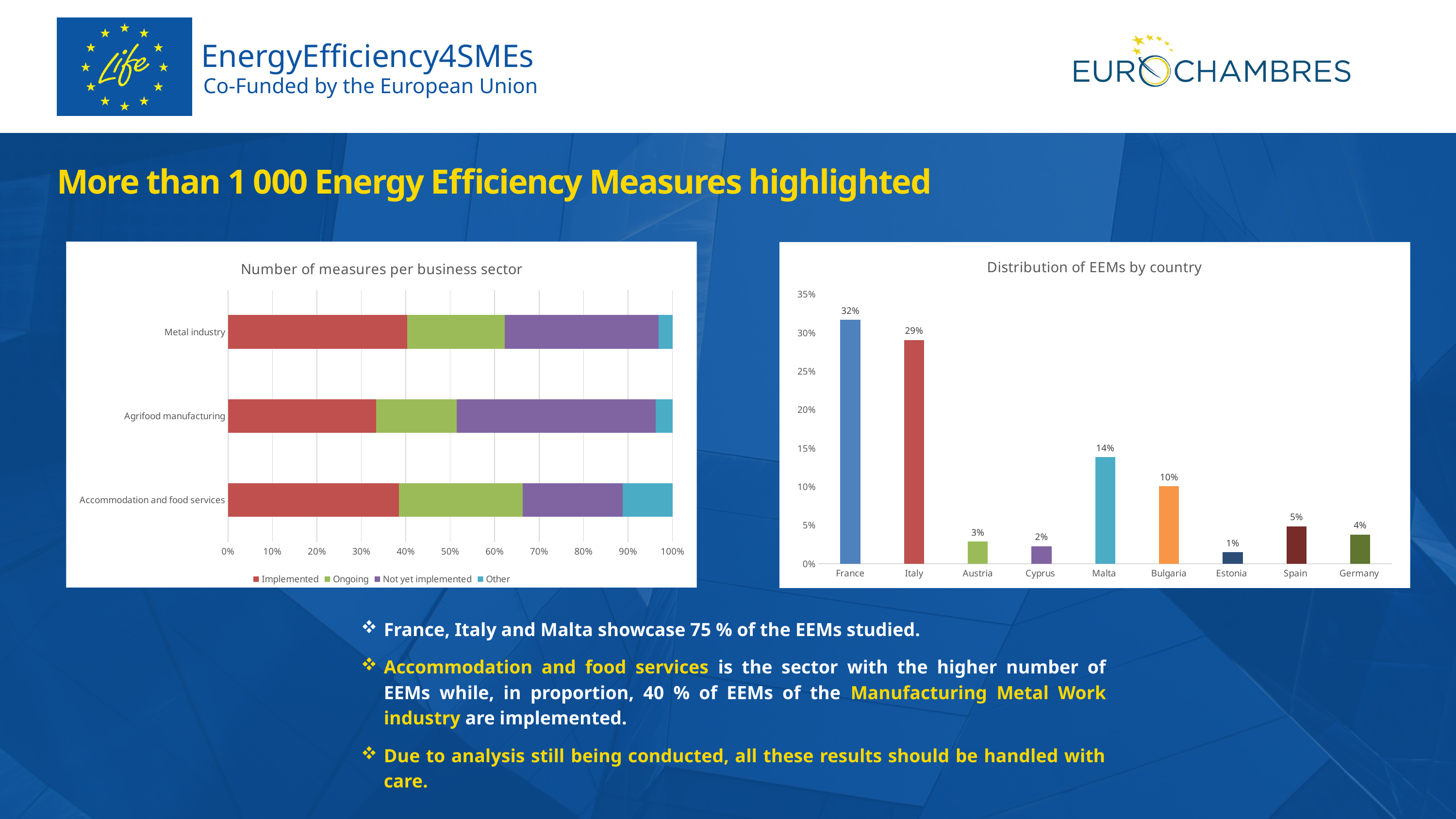
In the 'Distribution of EEMs by country' chart, which country has the highest value? France In the 'Distribution of EEMs by country' chart, what is the difference between the values for Italy and Bulgaria? 19% In the 'Distribution of EEMs by country' chart, what is the value for France? 32% How many countries are shown in the 'Distribution of EEMs by country' chart? 9 How many series does the legend of the 'Number of measures per business sector' chart list? 4 In the 'Distribution of EEMs by country' chart, what is the value for Malta? 14% How many business sectors are shown in the 'Number of measures per business sector' chart? 3 In the 'Number of measures per business sector' chart, is the Implemented share for Metal industry greater or less than 30%? greater In the 'Number of measures per business sector' chart, which series is shown in green? Ongoing In the 'Distribution of EEMs by country' chart, which country has the lowest value? Estonia In the 'Distribution of EEMs by country' chart, which has a larger value, Spain or Germany? Spain What kind of chart is 'Distribution of EEMs by country'? Bar chart